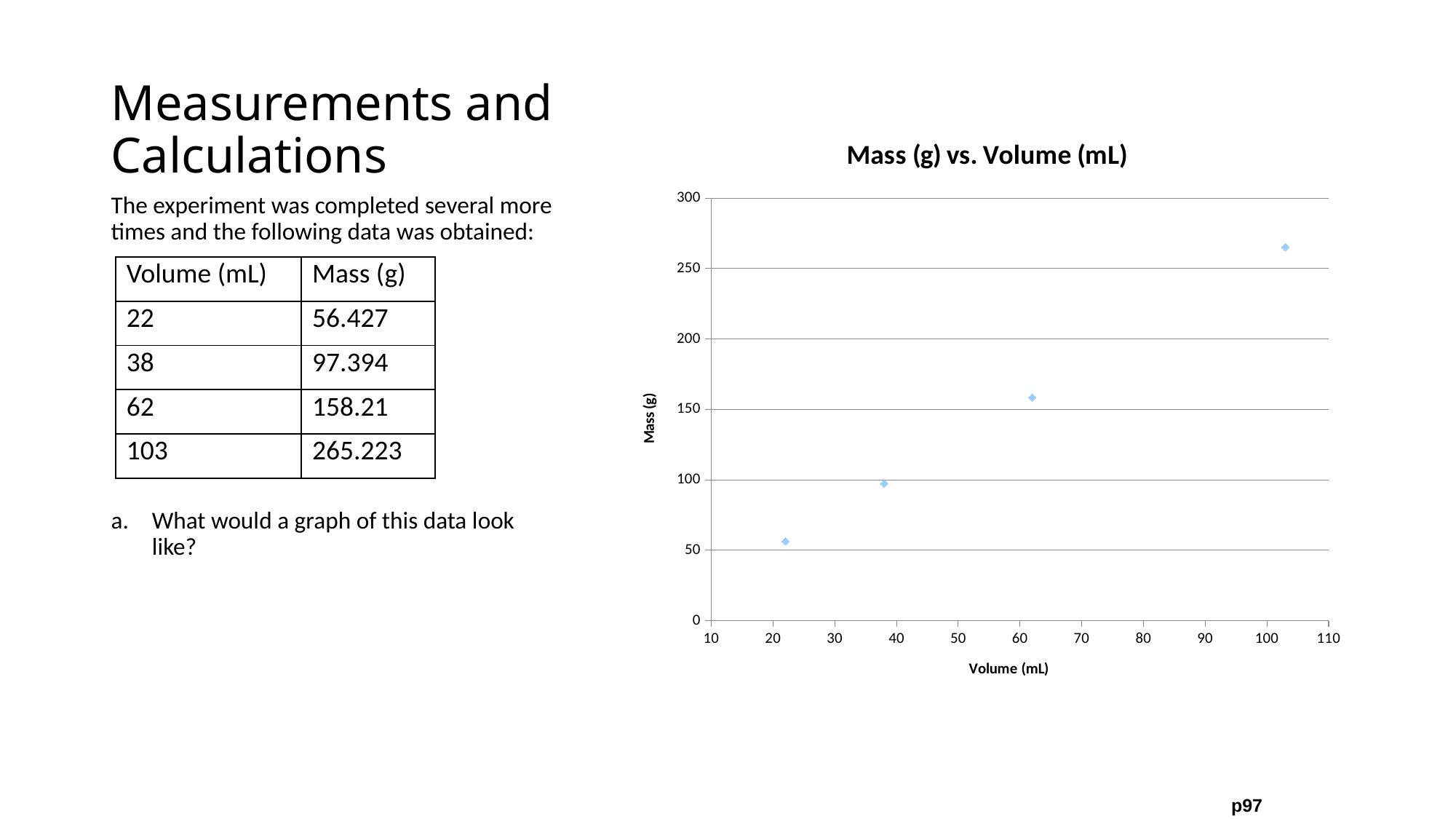
How many data points are plotted on the chart? 4 Is the mass at a volume of 38 mL greater or less than 100? less Is the mass at a volume of 103 mL greater or less than 250? greater Is the mass at a volume of 62 mL greater or less than 150? greater What kind of chart is shown on the slide? scatter plot Which volume has the lowest mass on the chart? 22 Which volume has the highest mass on the chart? 103 Does mass rise or fall as volume increases along the x axis? rise Which has the larger mass: the point at 62 mL or the point at 38 mL? 62 mL What is the title of the chart? Mass (g) vs. Volume (mL) What is the label of the x axis of the chart? Volume (mL)